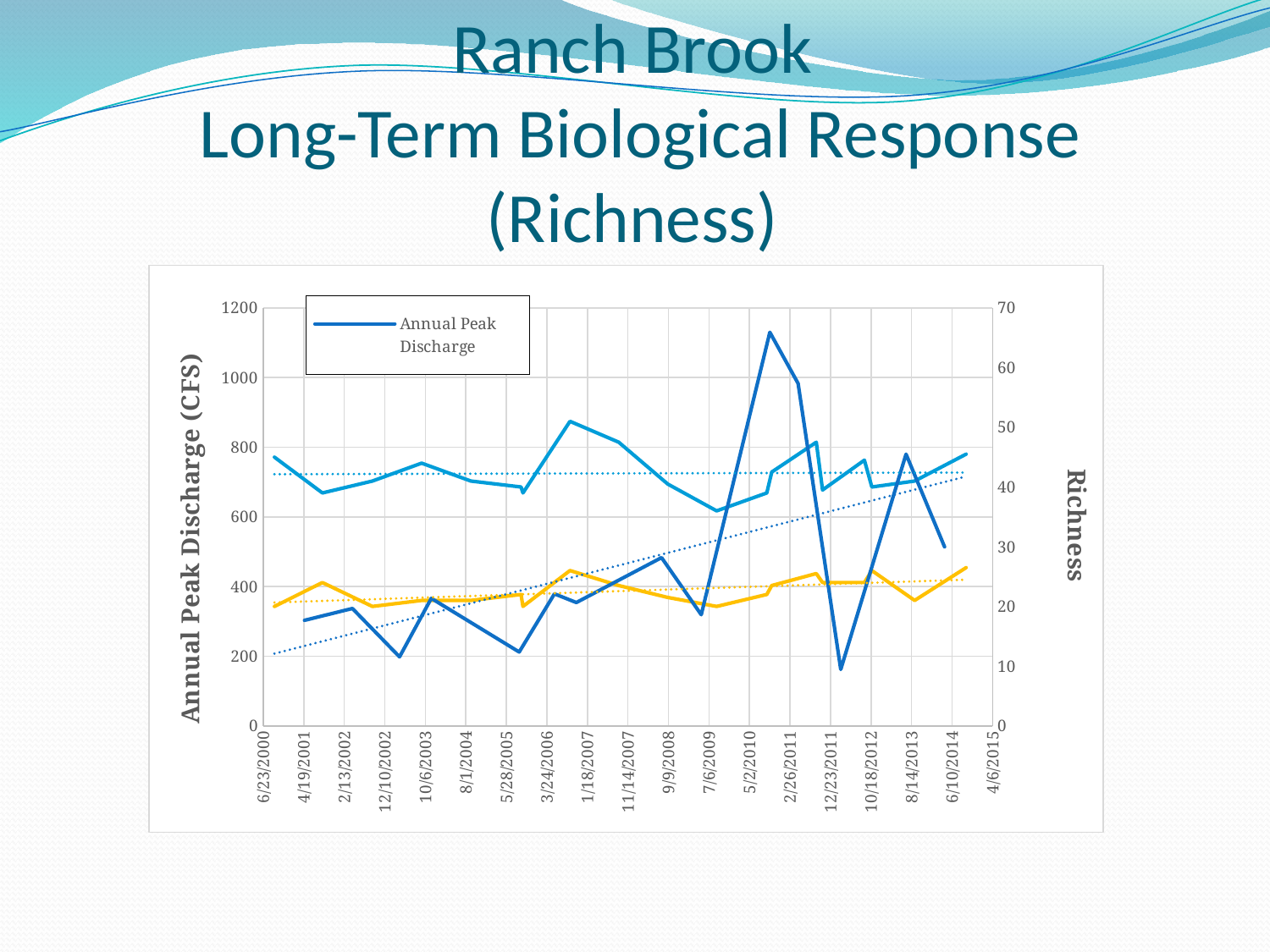
Is the Annual Peak Discharge value at 6/10/2014 greater or less than 600? less Is the Annual Peak Discharge value at 4/19/2001 greater or less than 400? less Is the highest value of the Annual Peak Discharge line greater or less than 1000? greater Does the dotted trend line for Annual Peak Discharge rise or fall from left to right? rise What is the title of the left vertical axis? Annual Peak Discharge (CFS) What is the maximum value shown on the right-hand Richness axis? 70 What series name appears in the chart's legend? Annual Peak Discharge What kind of chart is shown on the slide? line chart Which is larger, the Annual Peak Discharge at 8/14/2013 or at 12/23/2011? 8/14/2013 How many series does the chart's legend list? 1